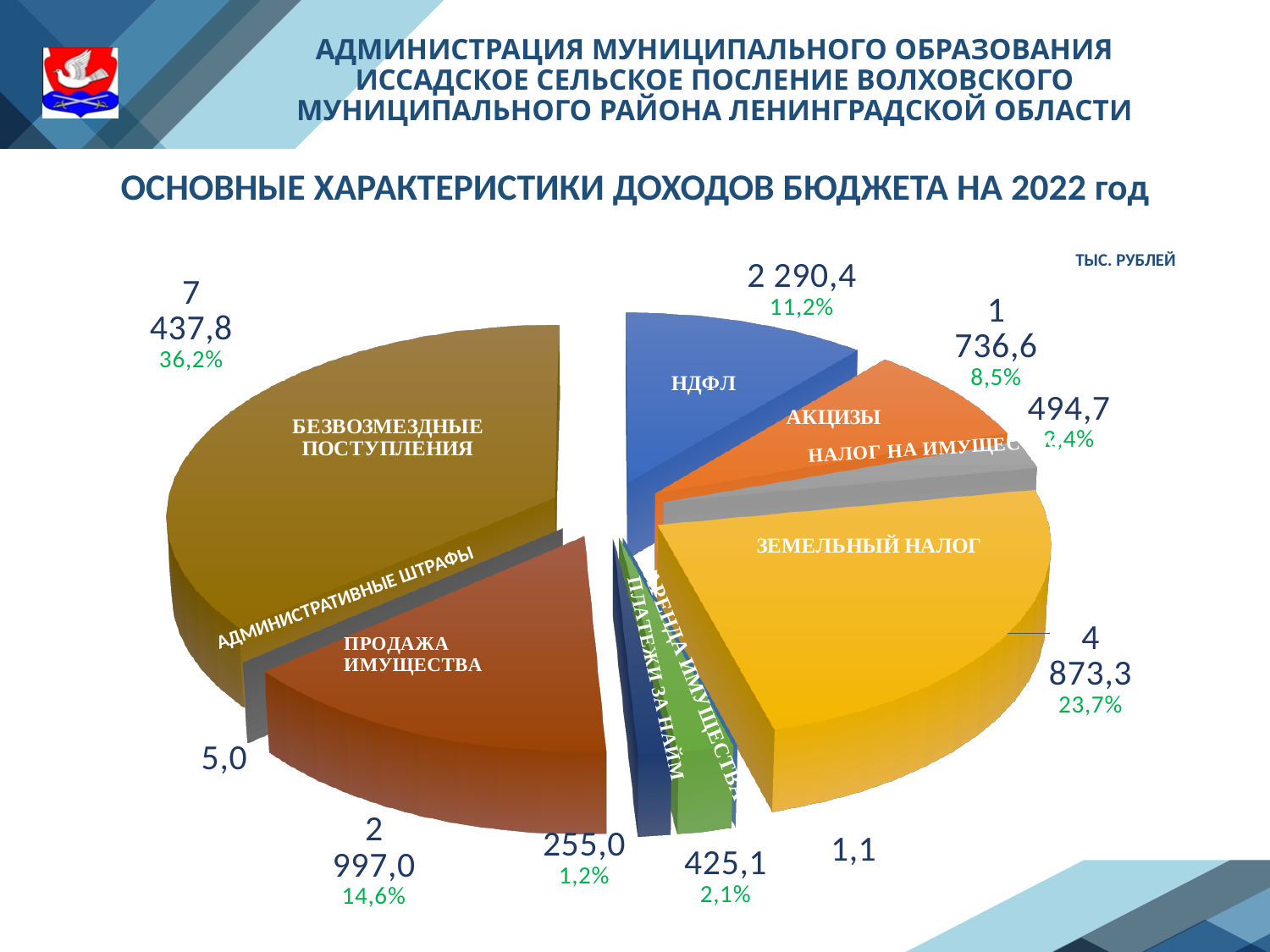
What share of the pie does БЕЗВОЗМЕЗДНЫЕ ПОСТУПЛЕНИЯ represent? 36,2% Which category has the largest slice of the pie? БЕЗВОЗМЕЗДНЫЕ ПОСТУПЛЕНИЯ In what units are the chart values given? ТЫС. РУБЛЕЙ What is the value for ЗЕМЕЛЬНЫЙ НАЛОГ? 4 873,3 Which is larger, НДФЛ or АКЦИЗЫ? НДФЛ What share of the pie does ЗЕМЕЛЬНЫЙ НАЛОГ represent? 23,7% What kind of chart is shown on the slide? pie chart What is the difference between БЕЗВОЗМЕЗДНЫЕ ПОСТУПЛЕНИЯ and ЗЕМЕЛЬНЫЙ НАЛОГ? 2 564,5 What is the value for НДФЛ? 2 290,4 What is the value for АКЦИЗЫ? 1 736,6 What is the value for БЕЗВОЗМЕЗДНЫЕ ПОСТУПЛЕНИЯ? 7 437,8 What is the value for ПРОДАЖА ИМУЩЕСТВА? 2 997,0